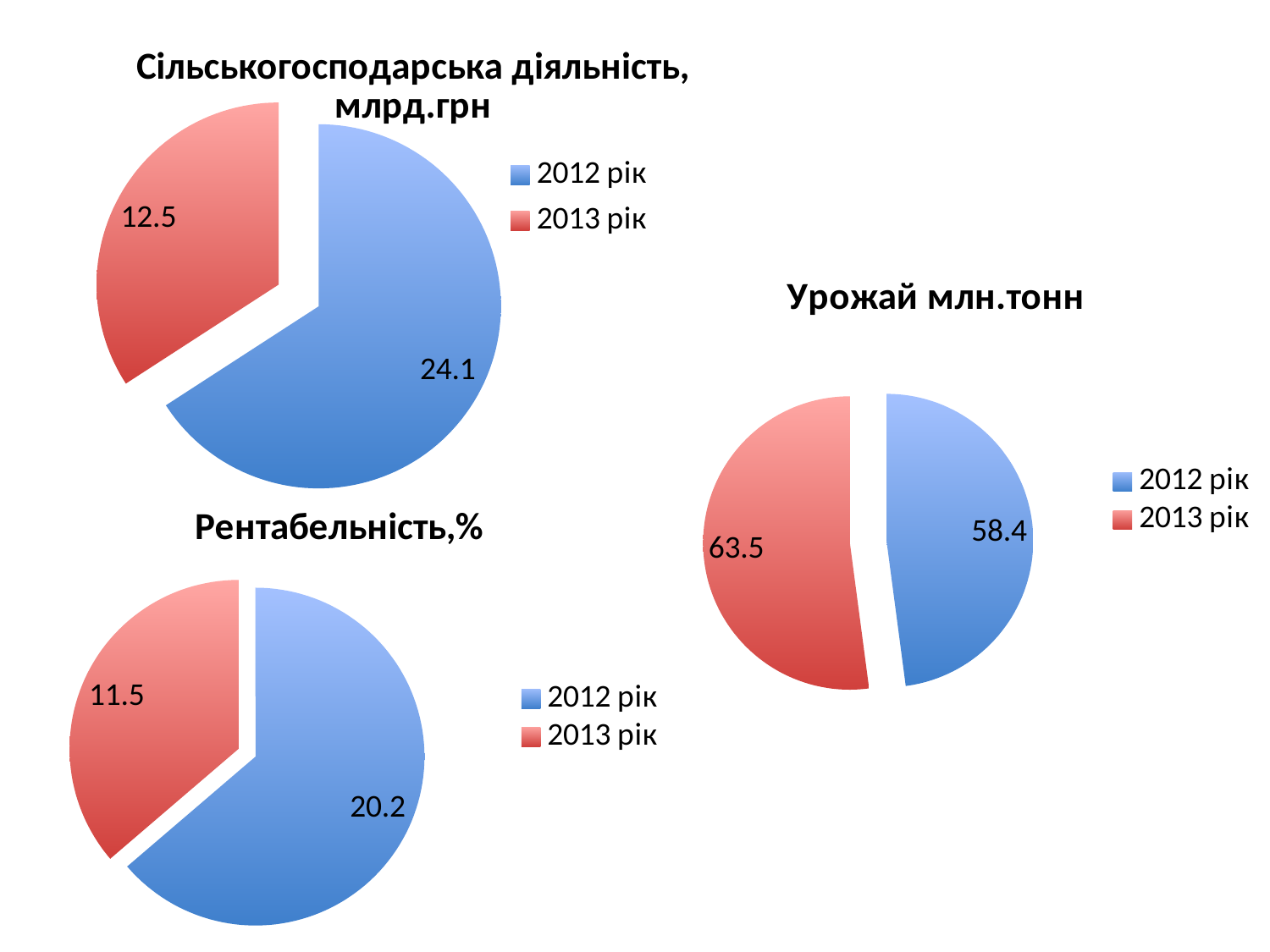
In the chart titled "Урожай млн.тонн", which year has the larger value? 2013 рік In the chart titled "Сільськогосподарська діяльність, млрд.грн", what is the value for 2013 рік? 12.5 In the chart titled "Урожай млн.тонн", what is the difference between the 2013 рік and 2012 рік values? 5.1 In the chart titled "Рентабельність,%", what is the value for 2013 рік? 11.5 In the chart titled "Сільськогосподарська діяльність, млрд.грн", what is the value for 2012 рік? 24.1 How many series does the legend of the chart titled "Рентабельність,%" list? 2 In the chart titled "Урожай млн.тонн", what is the value for 2012 рік? 58.4 In the chart titled "Рентабельність,%", is the value for 2012 рік larger or smaller than the value for 2013 рік? larger In the chart titled "Сільськогосподарська діяльність, млрд.грн", what is the difference between the 2012 рік and 2013 рік values? 11.6 What kind of chart is the chart titled "Урожай млн.тонн"? pie chart In the chart titled "Рентабельність,%", which year has the smaller value? 2013 рік How many charts are shown on the slide? 3